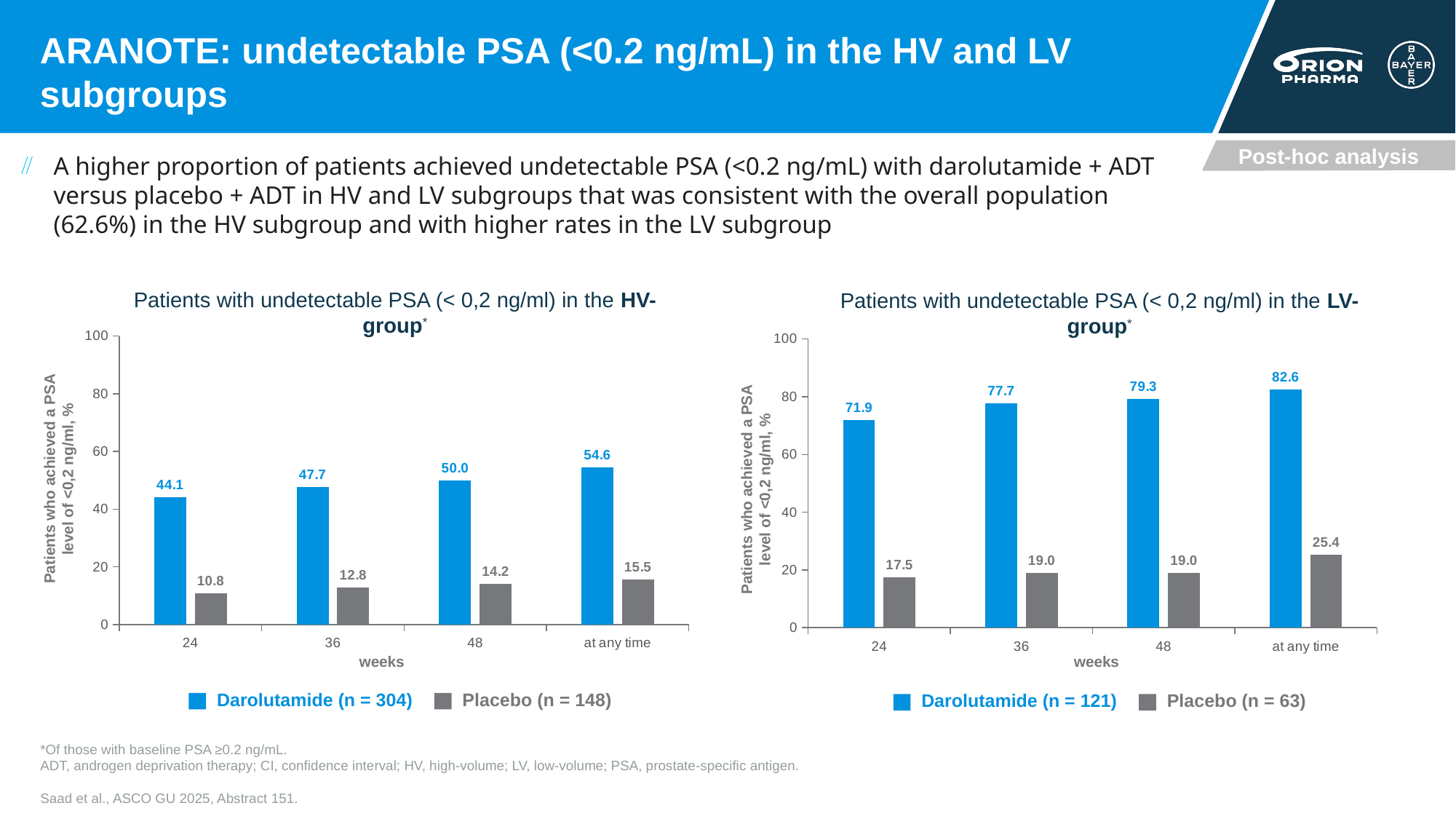
How many series does the legend of the LV-group chart list? 2 In the HV-group chart, what is the value for Placebo at 48 weeks? 14.2 In the LV-group chart, at which time point is the Darolutamide value highest? at any time In the LV-group chart, what is the difference between the Darolutamide values at 48 weeks and 24 weeks? 7.4 In the HV-group chart, at which time point is the Placebo value lowest? 24 In the HV-group chart, what is the value for Darolutamide at 24 weeks? 44.1 In the HV-group chart, how many time points are shown on the x axis? 4 In the LV-group chart, do the Darolutamide values rise or fall from 24 weeks to at any time? rise In the HV-group chart, what is the difference between the Darolutamide and Placebo values at any time? 39.1 In the LV-group chart, which is larger: Darolutamide at 36 weeks or Darolutamide at 48 weeks? Darolutamide at 48 weeks In the LV-group chart, what is the value for Placebo at any time? 25.4 What kind of chart is the HV-group chart? bar chart